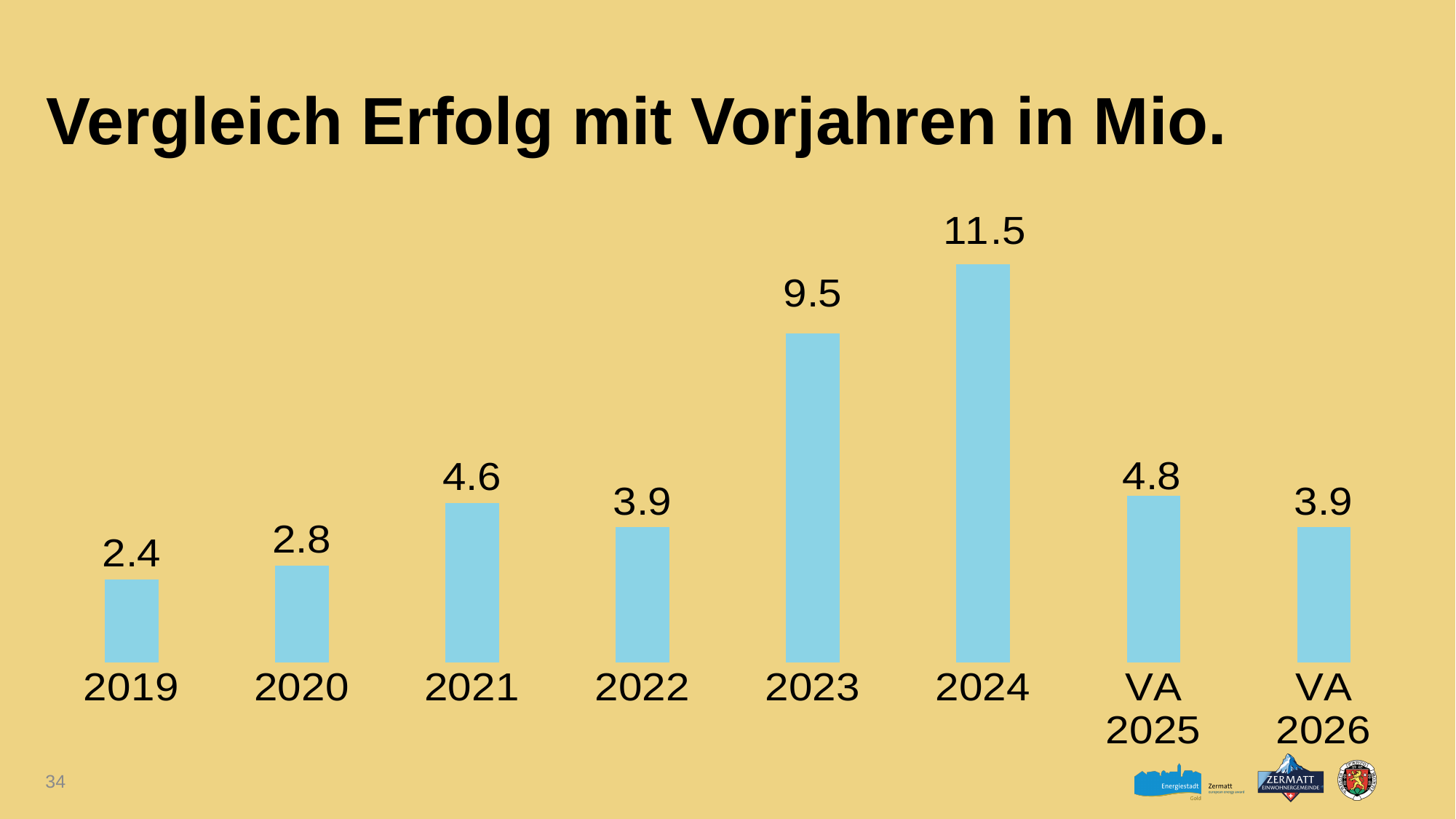
What is the value for 2023? 9.5 Which category has the highest value? 2024 What is the title of the slide? Vergleich Erfolg mit Vorjahren in Mio. What kind of chart is shown on the slide? bar chart What is the value for VA 2025? 4.8 What is the difference between the values for 2024 and 2023? 2.0 Do the values rise or fall from 2019 to 2021? rise Which category has the lowest value? 2019 Which is larger, the value for 2021 or the value for VA 2026? 2021 What is the difference between the values for 2021 and 2022? 0.7 How many categories are shown on the x axis? 8 What is the value for 2019? 2.4